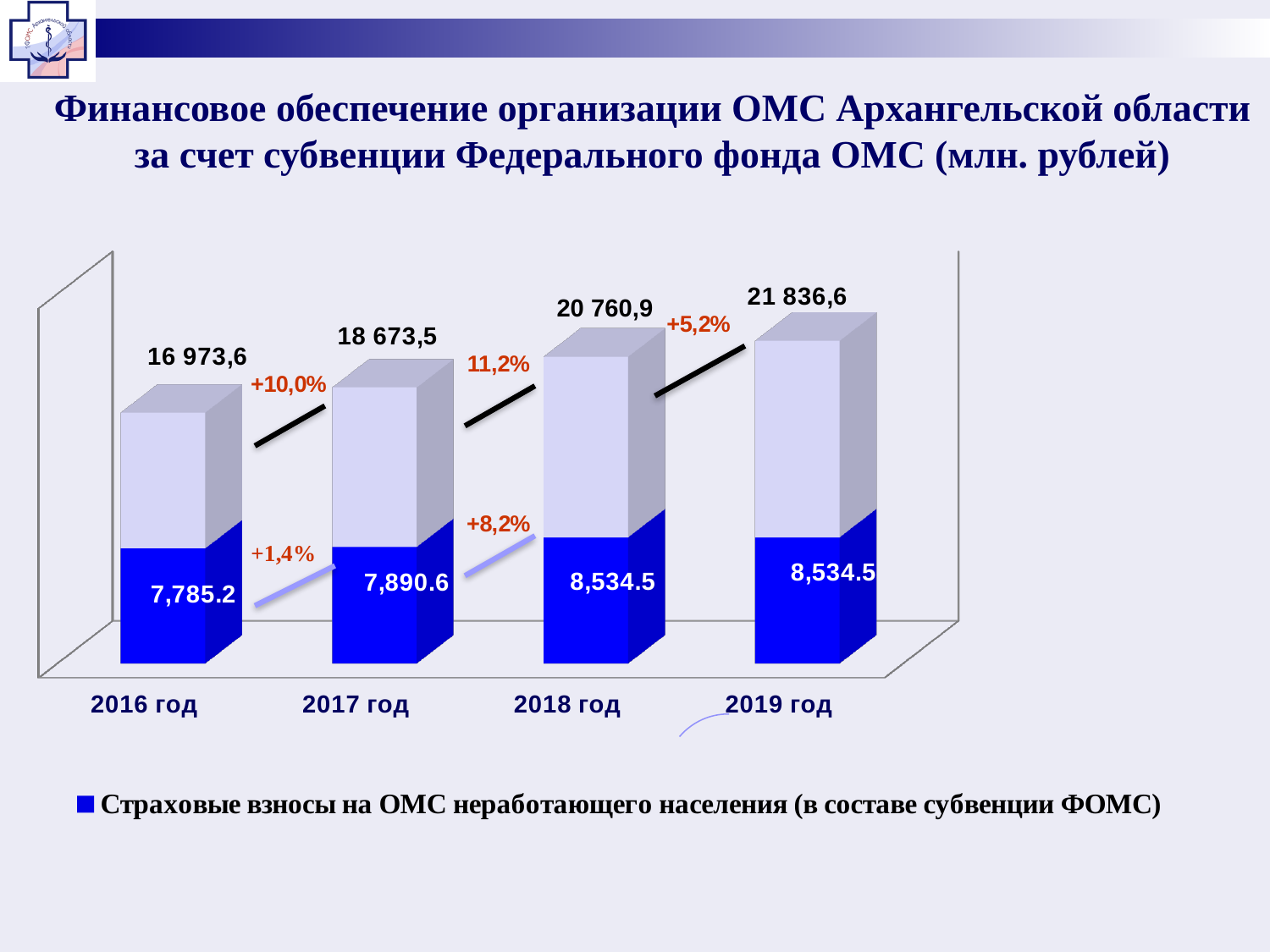
Which year has the highest total value? 2019 год Which year has the lowest value for the blue segment (Страховые взносы на ОМС неработающего населения)? 2016 год What percentage change is labelled between the total values for 2016 год and 2017 год? +10,0% What is the value of the blue segment (Страховые взносы на ОМС неработающего населения) for 2018 год? 8,534.5 Do the total values rise or fall from 2016 год to 2019 год? rise What is the total value shown above the bar for 2017 год? 18 673,5 How many years are shown on the x axis of the chart? 4 What kind of chart is shown on the slide? bar chart How many series does the legend list? 1 What is the difference between the total values for 2019 год and 2018 год? 1 075,7 What is the difference between the blue segment values for 2018 год and 2017 год? 643.9 Which is larger, the blue segment value for 2016 год or for 2017 год? 2017 год